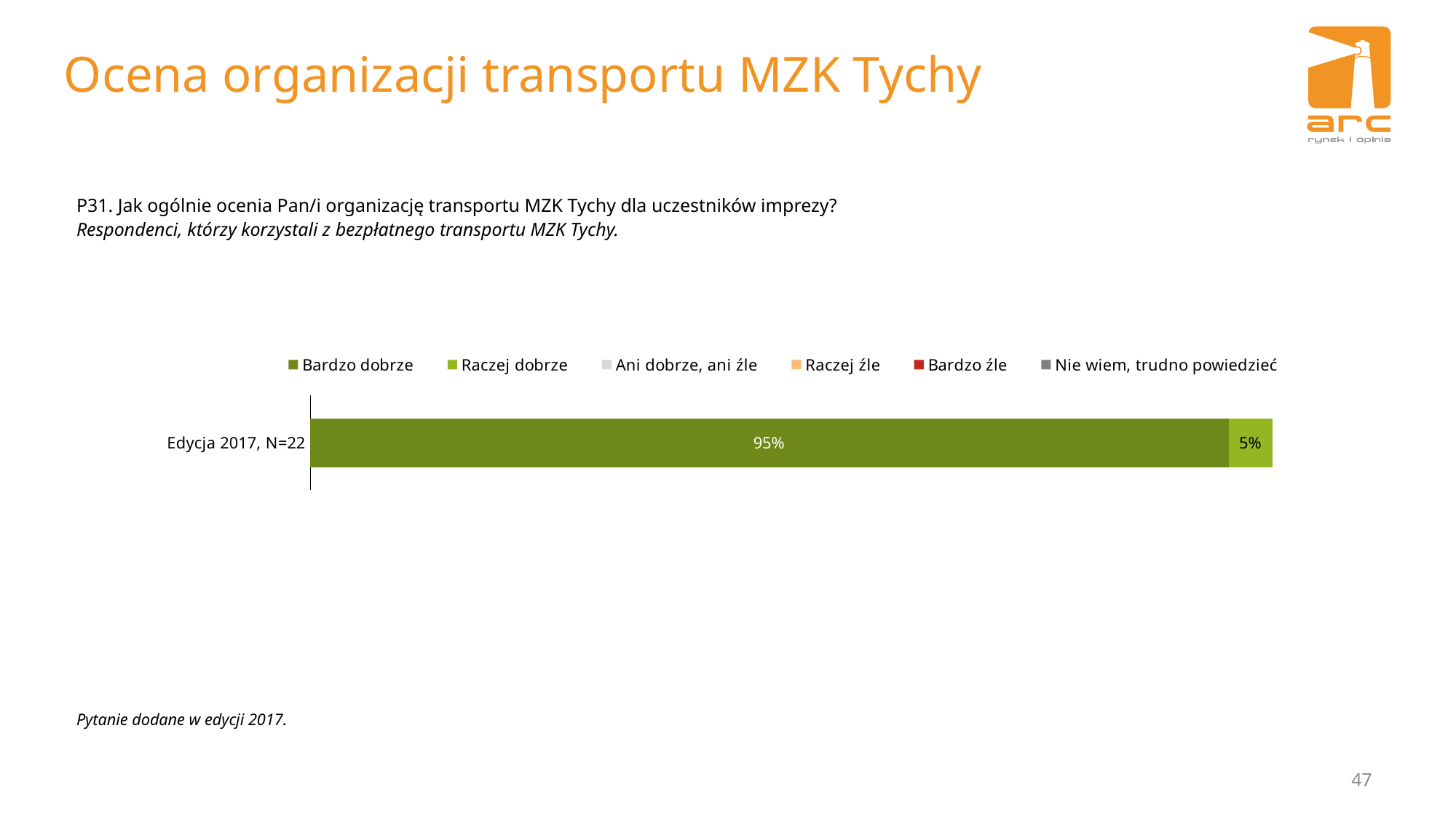
Which is larger for Edycja 2017: the 'Bardzo dobrze' share or the 'Raczej dobrze' share? Bardzo dobrze What is the total of the labelled segments in the Edycja 2017 bar? 100% What is the sample size (N) shown for Edycja 2017? 22 How many bars (categories) are plotted in the chart? 1 What percentage of respondents in Edycja 2017 rated the MZK Tychy transport organisation 'Bardzo dobrze'? 95% How many series does the legend list? 6 What is the difference between the 'Bardzo dobrze' and 'Raczej dobrze' shares for Edycja 2017? 90 percentage points Which response category has the largest share in the Edycja 2017 bar? Bardzo dobrze What kind of chart is shown on the slide? Stacked horizontal bar chart What is the label of the single bar in the chart? Edycja 2017, N=22 What percentage of respondents in Edycja 2017 rated the MZK Tychy transport organisation 'Raczej dobrze'? 5%